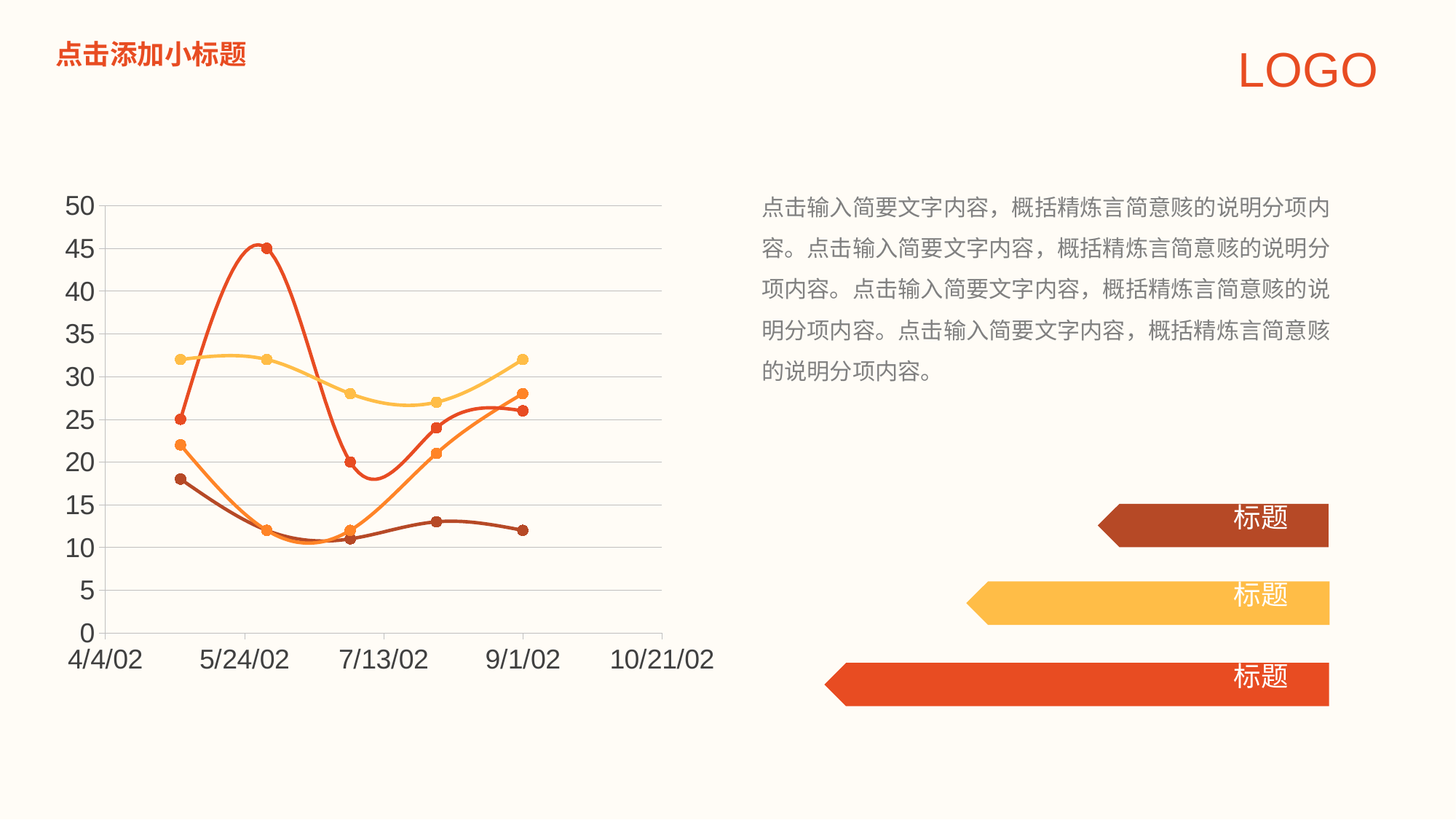
How many lines are plotted on the chart? 4 Is the last point of the yellow line greater or less than 30? greater What kind of chart is shown on the slide? line chart Which line reaches the highest value on the chart? the red line How many data points does each line on the chart have? 5 Does the chart display a legend? No Is the peak of the red line greater or less than 40? greater At the first data point, which line is higher, the yellow line or the brown line? the yellow line What is the first label on the x axis of the chart? 4/4/02 What is the highest value reached by the red line? 45 Does the brown line end higher or lower than it starts? lower Is the lowest point of the brown line greater or less than 15? less